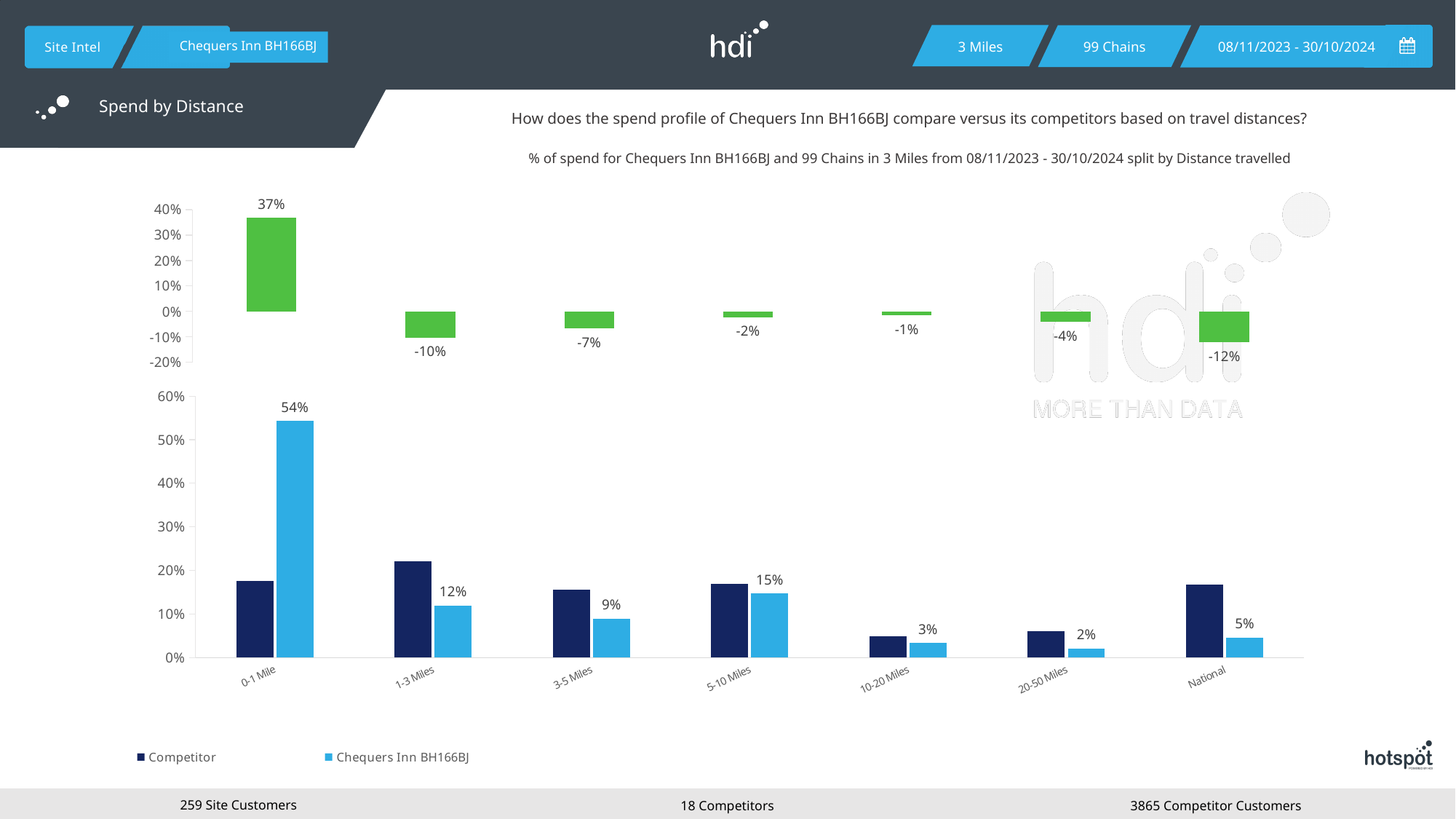
In the bottom chart, what is the difference between the Chequers Inn BH166BJ values for 0-1 Mile and 1-3 Miles? 42 percentage points In the bottom chart, is the Competitor value for 10-20 Miles greater or less than 10%? less In the bottom chart, what is the value for Chequers Inn BH166BJ in the 0-1 Mile category? 54% In the top chart with green bars, what is the value of the leftmost bar? 37% In the top chart with green bars, what is the value of the rightmost bar? -12% How many series does the legend of the bottom chart list? 2 In the bottom chart, which distance category has the lowest value for Chequers Inn BH166BJ? 20-50 Miles In the bottom chart, what is the value for Chequers Inn BH166BJ in the 5-10 Miles category? 15% How many distance categories are shown on the x axis of the bottom chart? 7 In the bottom chart, which series has the larger value for 1-3 Miles, Competitor or Chequers Inn BH166BJ? Competitor In the bottom chart, is the Competitor value for 1-3 Miles greater or less than 20%? greater In the bottom chart, which distance category has the highest value for Chequers Inn BH166BJ? 0-1 Mile